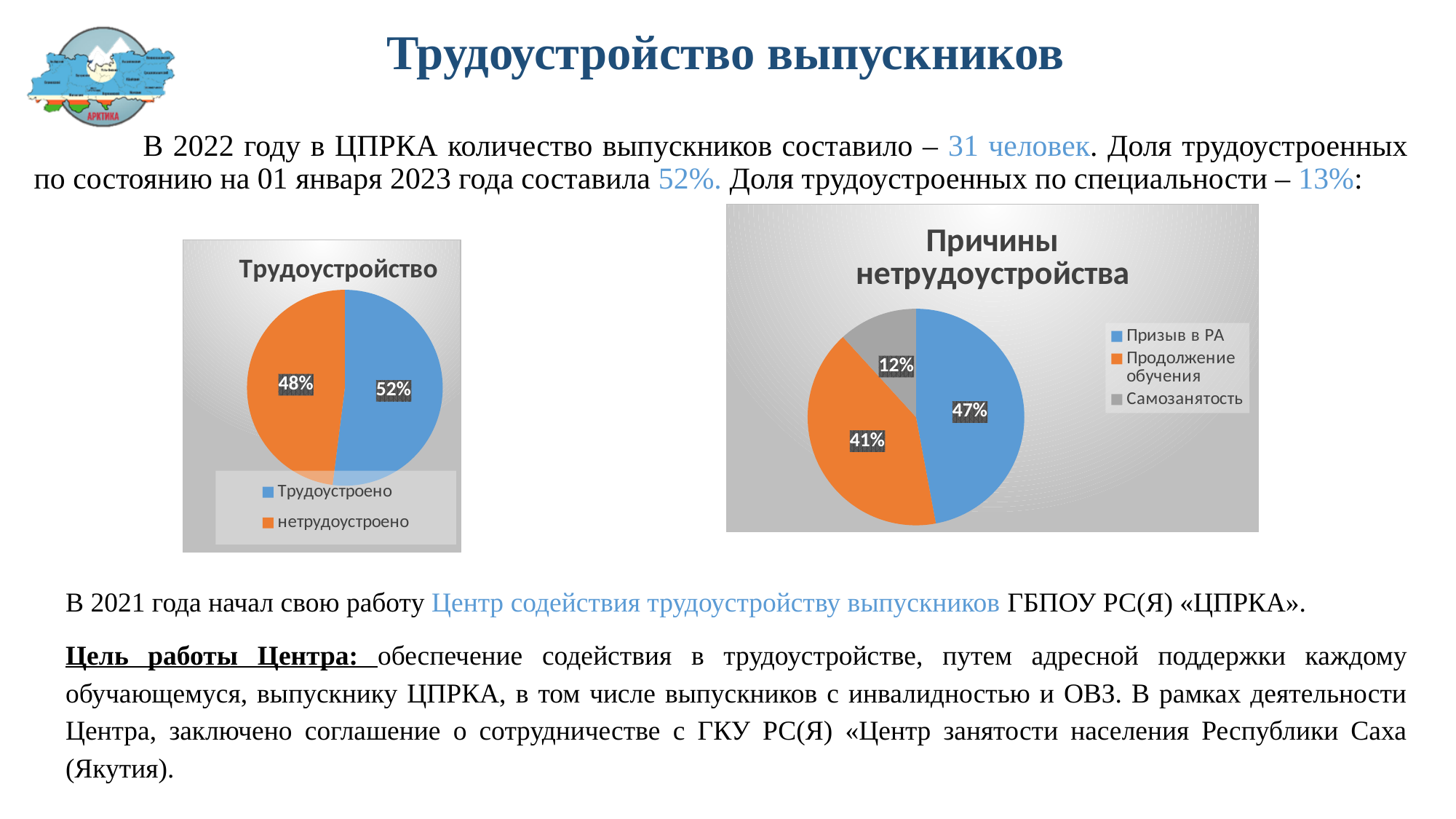
In the chart titled "Причины нетрудоустройства", which category has the smallest share? Самозанятость In the chart titled "Трудоустройство", what is the difference in percentage points between "Трудоустроено" and "нетрудоустроено"? 4 In the chart titled "Причины нетрудоустройства", what share is labelled for "Самозанятость"? 12% How many categories does the legend of the chart titled "Причины нетрудоустройства" list? 3 In the chart titled "Причины нетрудоустройства", which category has the largest share? Призыв в РА In the chart titled "Причины нетрудоустройства", what share is labelled for "Призыв в РА"? 47% In the chart titled "Трудоустройство", what share is labelled for "нетрудоустроено"? 48% In the chart titled "Причины нетрудоустройства", what share is labelled for "Продолжение обучения"? 41% In the chart titled "Трудоустройство", what share is labelled for "Трудоустроено"? 52% In the chart titled "Причины нетрудоустройства", what is the difference in percentage points between "Призыв в РА" and "Самозанятость"? 35 In the chart titled "Трудоустройство", which slice is larger, "Трудоустроено" or "нетрудоустроено"? Трудоустроено What kind of chart is the chart titled "Трудоустройство"? Pie chart